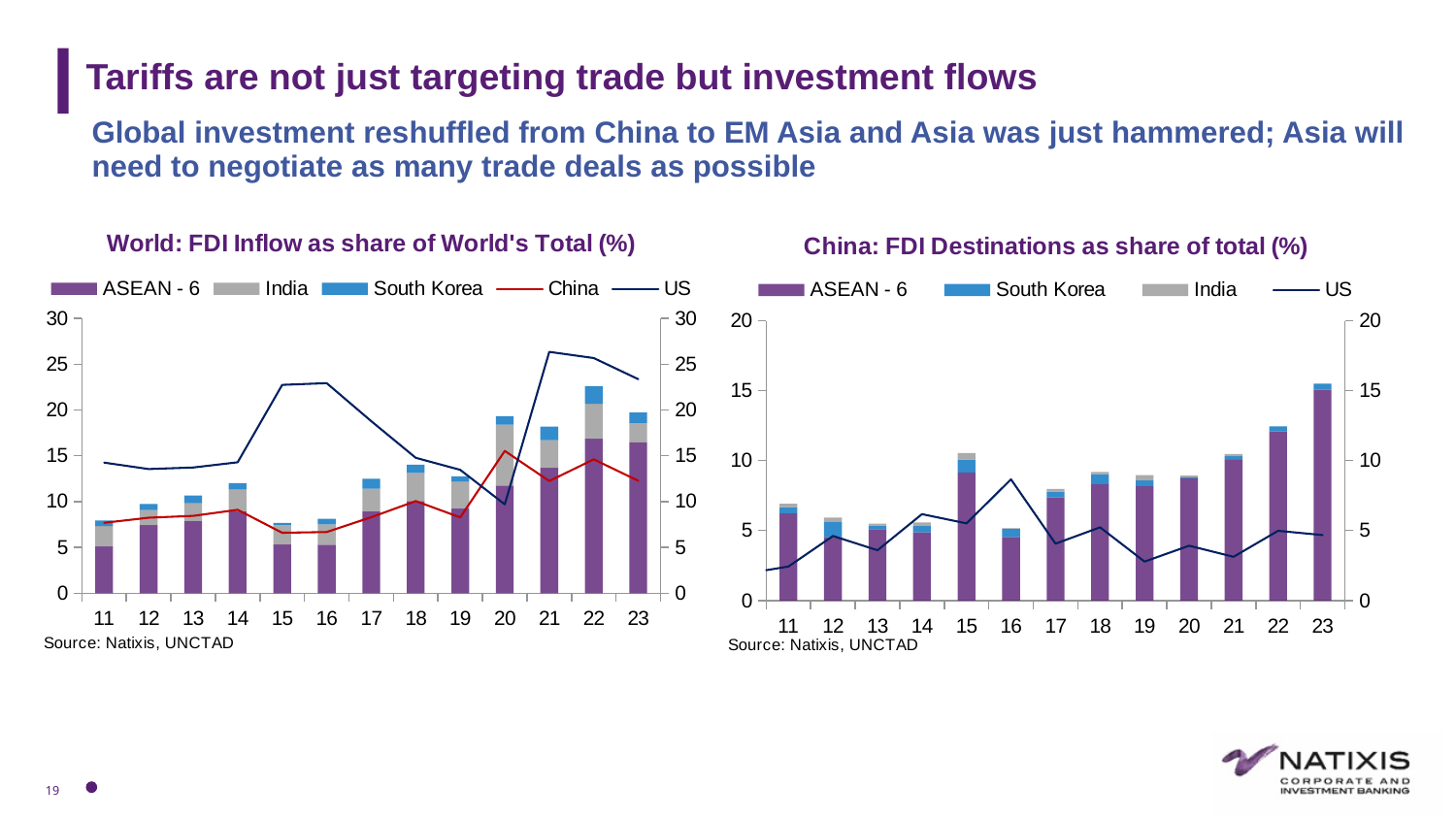
In the left chart, 'World: FDI Inflow as share of World's Total (%)', is the China value in 11 greater or less than 10? less What type of chart is the left chart, 'World: FDI Inflow as share of World's Total (%)'? A combination of a stacked bar chart and line chart In the left chart, 'World: FDI Inflow as share of World's Total (%)', which is larger in 21, the US value or the China value? US In the right chart, 'China: FDI Destinations as share of total (%)', is the total stacked bar for 22 greater or less than 10? greater In the left chart, 'World: FDI Inflow as share of World's Total (%)', is the US value in 21 greater or less than 25? greater In the right chart, 'China: FDI Destinations as share of total (%)', which year has the tallest stacked bar? 23 How many years are shown on the x axis of the right chart, 'China: FDI Destinations as share of total (%)'? 13 How many series does the legend of the right chart, 'China: FDI Destinations as share of total (%)', list? 4 In the left chart, 'World: FDI Inflow as share of World's Total (%)', in which year does the US line reach its highest value? 21 In the right chart, 'China: FDI Destinations as share of total (%)', in which year does the US line reach its highest value? 16 How many series does the legend of the left chart, 'World: FDI Inflow as share of World's Total (%)', list? 5